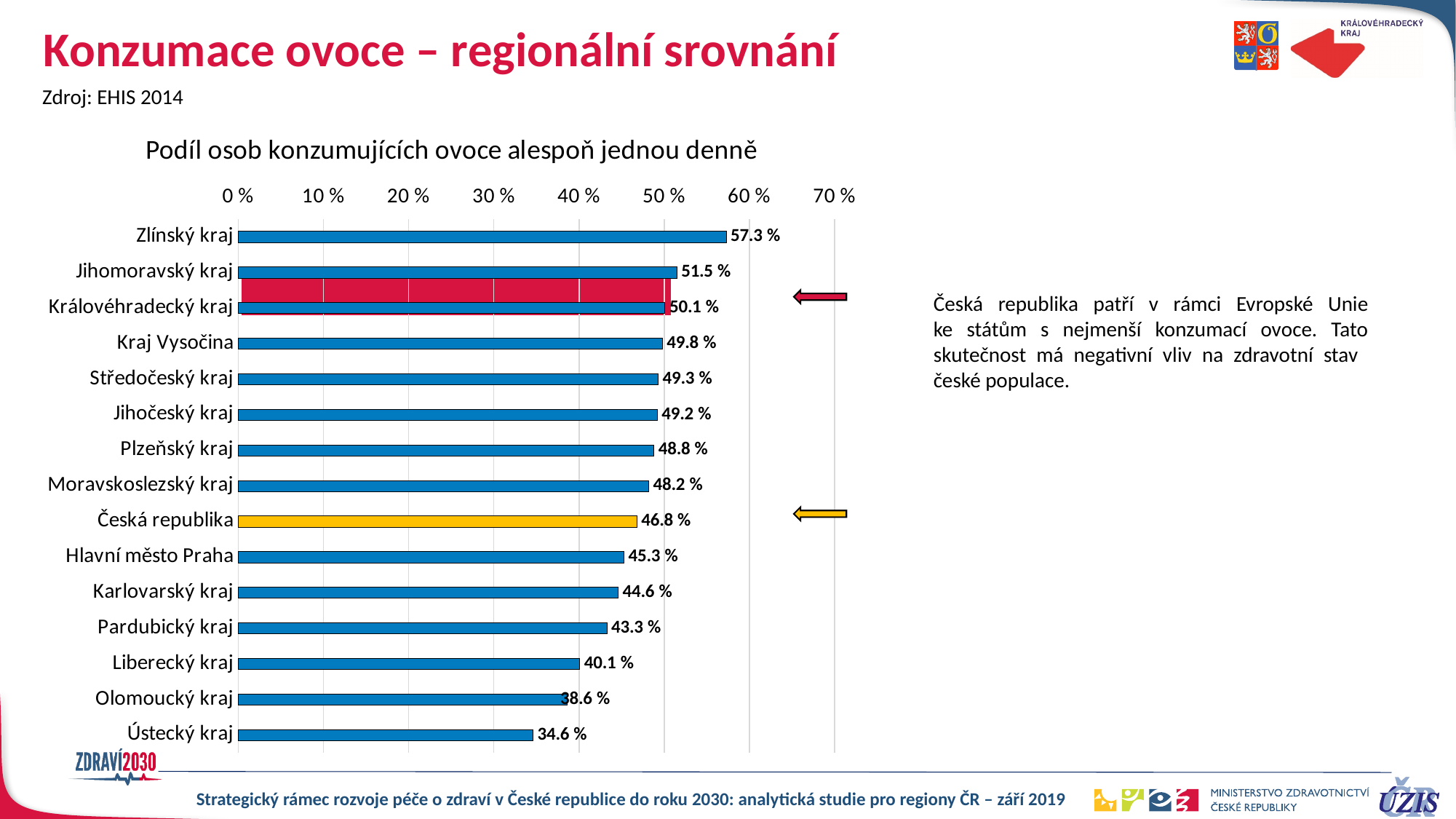
Which is larger, the value for Jihomoravský kraj or the value for Kraj Vysočina? Jihomoravský kraj What is the value for Zlínský kraj? 57.3 % Is the value for Olomoucký kraj greater or less than 40 %? less Which region has the lowest value? Ústecký kraj Which region has the highest value? Zlínský kraj What kind of chart is shown on the slide? bar chart What is the value for Česká republika? 46.8 % What is the difference between the values for Zlínský kraj and Ústecký kraj? 22.7 % What is the title of the chart? Podíl osob konzumujících ovoce alespoň jednou denně What is the value for Královéhradecký kraj? 50.1 % How many bars are shown in the chart? 15 Do the values increase or decrease going from the top bar to the bottom bar? decrease